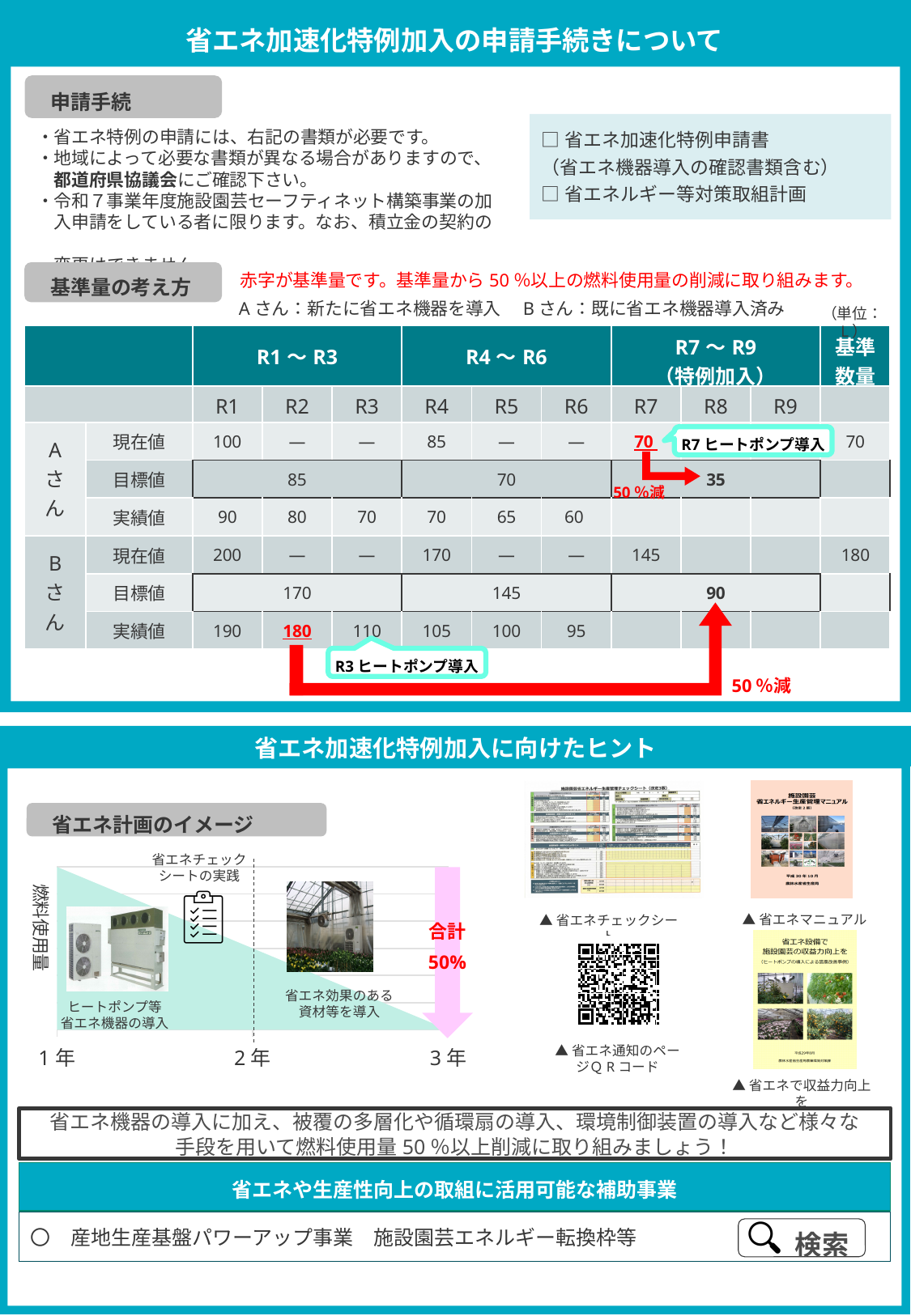
In the 省エネ計画のイメージ diagram, what total reduction is labelled next to the pink arrow? 合計 50% In the 省エネ計画のイメージ diagram, does fuel usage (燃料使用量) rise or fall from 1年 to 3年? fall In the 省エネ計画のイメージ diagram, how many year points are marked along the x axis? 3 In the 省エネ計画のイメージ diagram, what is the label on the vertical axis? 燃料使用量